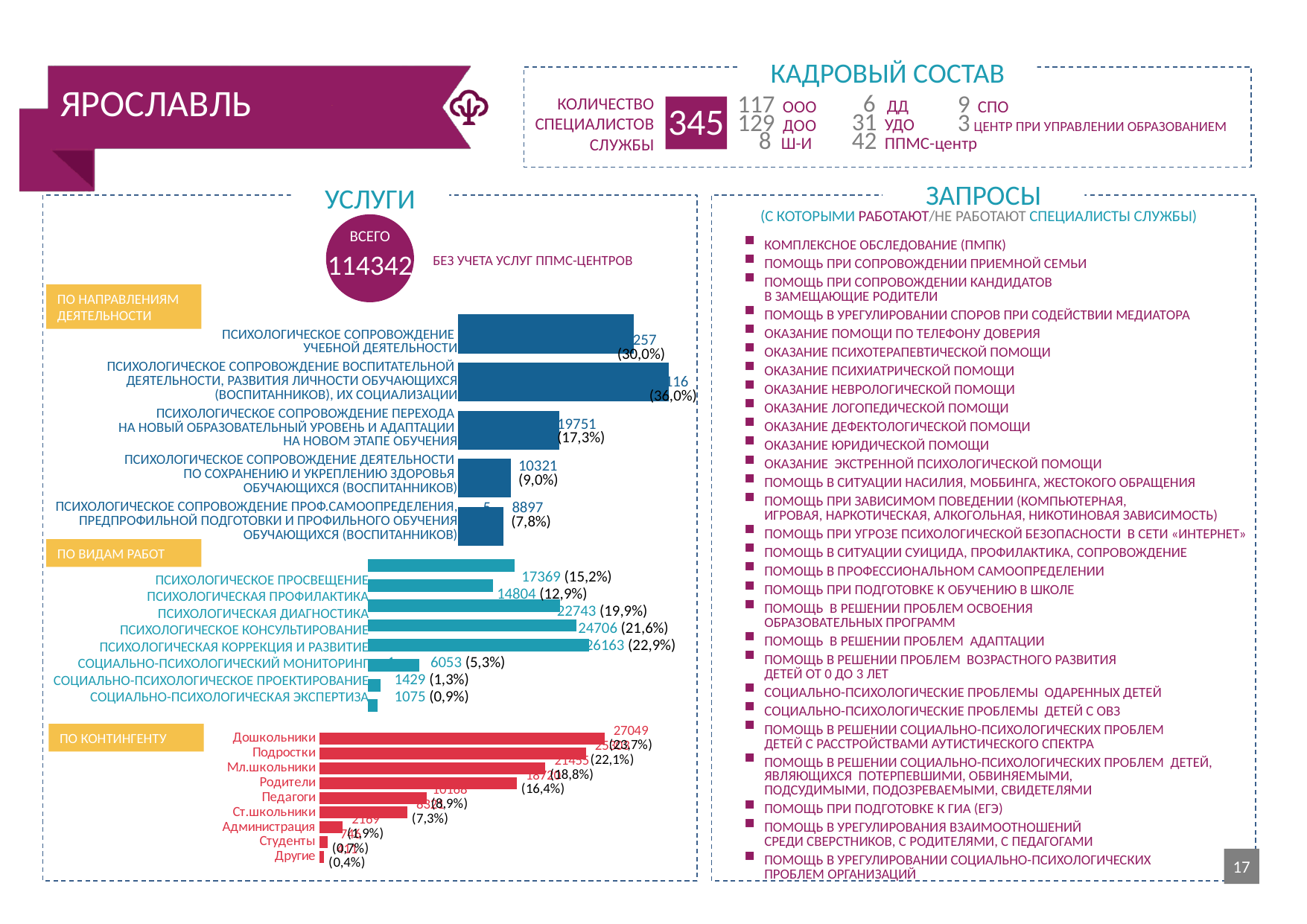
In the 'ПО НАПРАВЛЕНИЯМ ДЕЯТЕЛЬНОСТИ' chart, what is the value for ПСИХОЛОГИЧЕСКОЕ СОПРОВОЖДЕНИЕ ДЕЯТЕЛЬНОСТИ ПО СОХРАНЕНИЮ И УКРЕПЛЕНИЮ ЗДОРОВЬЯ ОБУЧАЮЩИХСЯ (ВОСПИТАННИКОВ)? 10321 In the 'ПО ВИДАМ РАБОТ' chart, how many categories are shown? 8 In the 'ПО ВИДАМ РАБОТ' chart, what is the difference between ПСИХОЛОГИЧЕСКОЕ ПРОСВЕЩЕНИЕ and ПСИХОЛОГИЧЕСКАЯ ПРОФИЛАКТИКА? 2565 In the 'ПО ВИДАМ РАБОТ' chart, what is the value for ПСИХОЛОГИЧЕСКОЕ КОНСУЛЬТИРОВАНИЕ? 24706 In the 'ПО НАПРАВЛЕНИЯМ ДЕЯТЕЛЬНОСТИ' chart, which category has the lowest value? ПСИХОЛОГИЧЕСКОЕ СОПРОВОЖДЕНИЕ ПРОФ.САМООПРЕДЕЛЕНИЯ, ПРЕДПРОФИЛЬНОЙ ПОДГОТОВКИ И ПРОФИЛЬНОГО ОБУЧЕНИЯ ОБУЧАЮЩИХСЯ (ВОСПИТАННИКОВ) In the 'ПО НАПРАВЛЕНИЯМ ДЕЯТЕЛЬНОСТИ' chart, what percentage is shown for ПСИХОЛОГИЧЕСКОЕ СОПРОВОЖДЕНИЕ ПЕРЕХОДА НА НОВЫЙ ОБРАЗОВАТЕЛЬНЫЙ УРОВЕНЬ И АДАПТАЦИИ НА НОВОМ ЭТАПЕ ОБУЧЕНИЯ? 17,3% In the 'ПО КОНТИНГЕНТУ' chart, what is the value for Дошкольники? 27049 What type of chart is the 'ПО КОНТИНГЕНТУ' chart? Bar chart In the 'ПО ВИДАМ РАБОТ' chart, which category has the lowest value? СОЦИАЛЬНО-ПСИХОЛОГИЧЕСКАЯ ЭКСПЕРТИЗА In the 'ПО ВИДАМ РАБОТ' chart, what is the value for ПСИХОЛОГИЧЕСКАЯ ДИАГНОСТИКА? 22743 In the 'ПО КОНТИНГЕНТУ' chart, which is larger: Педагоги or Администрация? Педагоги In the 'ПО ВИДАМ РАБОТ' chart, which category has the highest value? ПСИХОЛОГИЧЕСКАЯ КОРРЕКЦИЯ И РАЗВИТИЕ